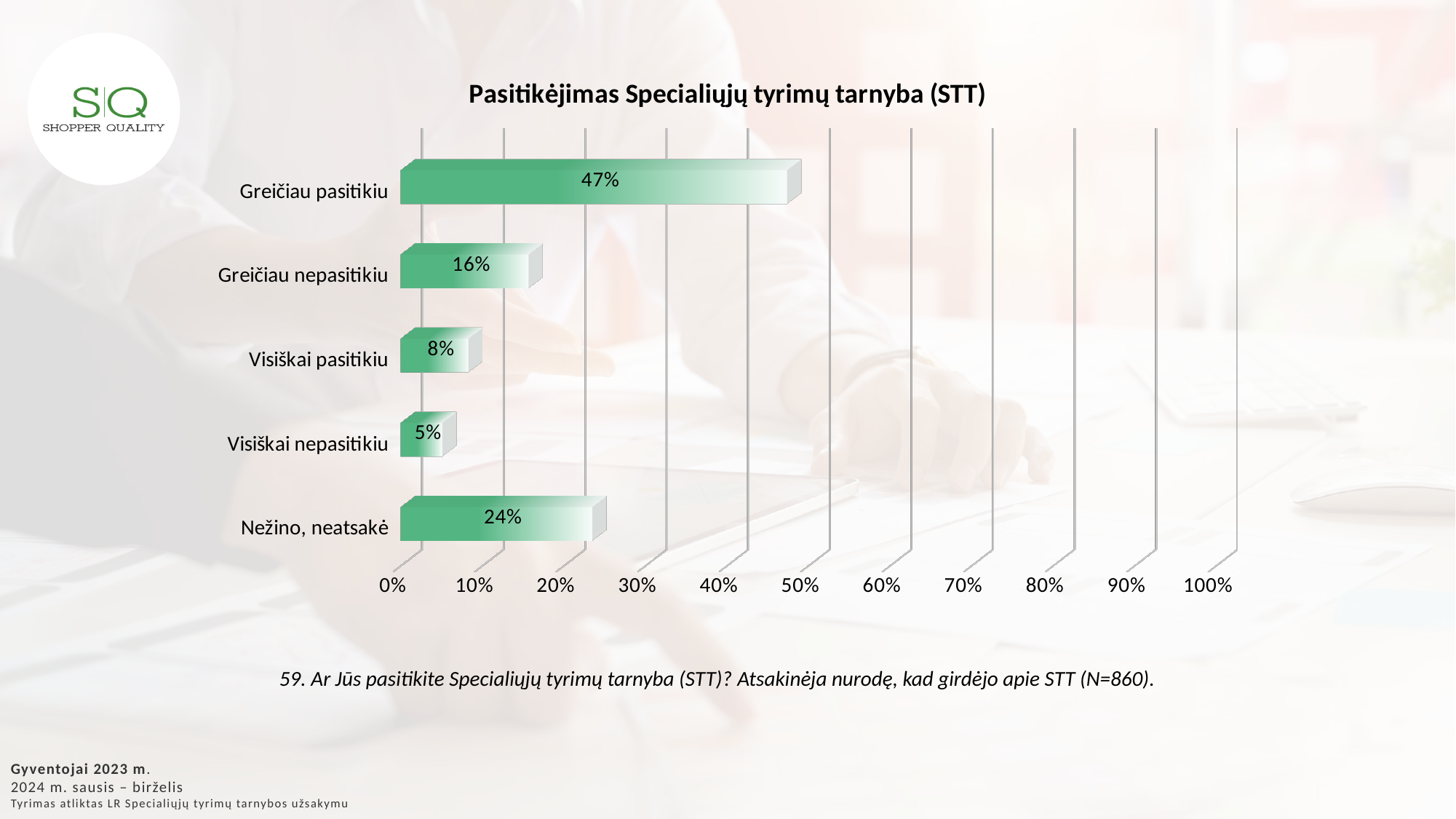
What is the difference between the values for "Greičiau pasitikiu" and "Nežino, neatsakė"? 23% What is the value for "Nežino, neatsakė"? 24% What is the value for "Visiškai nepasitikiu"? 5% What kind of chart is shown on the slide? bar chart What is the value for "Greičiau nepasitikiu"? 16% Which is larger, the value for "Greičiau nepasitikiu" or the value for "Visiškai pasitikiu"? Greičiau nepasitikiu What is the value for "Greičiau pasitikiu"? 47% How many categories are shown in the chart? 5 Which category has the lowest value? Visiškai nepasitikiu Is the value for "Greičiau pasitikiu" greater or less than 40%? greater What is the title of the chart? Pasitikėjimas Specialiųjų tyrimų tarnyba (STT) Which category has the highest value? Greičiau pasitikiu